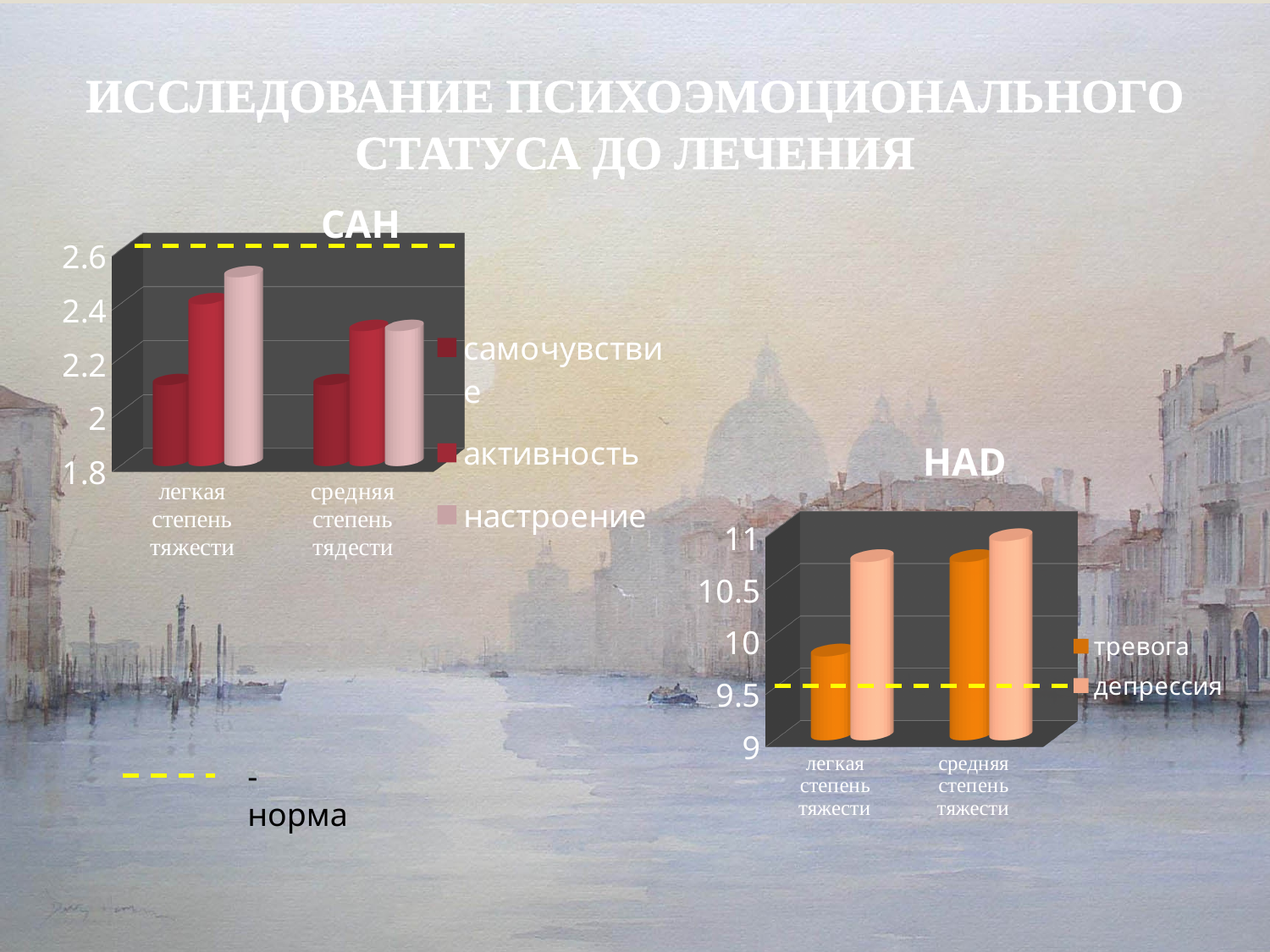
How many series does the legend of the САН chart list? 3 In the САН chart, is the value of настроение for легкая степень тяжести greater or less than 2.4? greater What does the yellow dashed line on the charts represent? норма In the САН chart, which series has the lowest value for легкая степень тяжести? самочувствие How many categories are shown on the x axis of the HAD chart? 2 What kind of chart is the САН chart? bar chart In the HAD chart, is the value of депрессия for средняя степень тяжести greater or less than 10.5? greater In the САН chart, which is larger for легкая степень тяжести: настроение or самочувствие? настроение How many series does the legend of the HAD chart list? 2 In the HAD chart, which is larger for легкая степень тяжести: тревога or депрессия? депрессия In the САН chart, is the value of самочувствие for легкая степень тяжести greater or less than 2.2? less